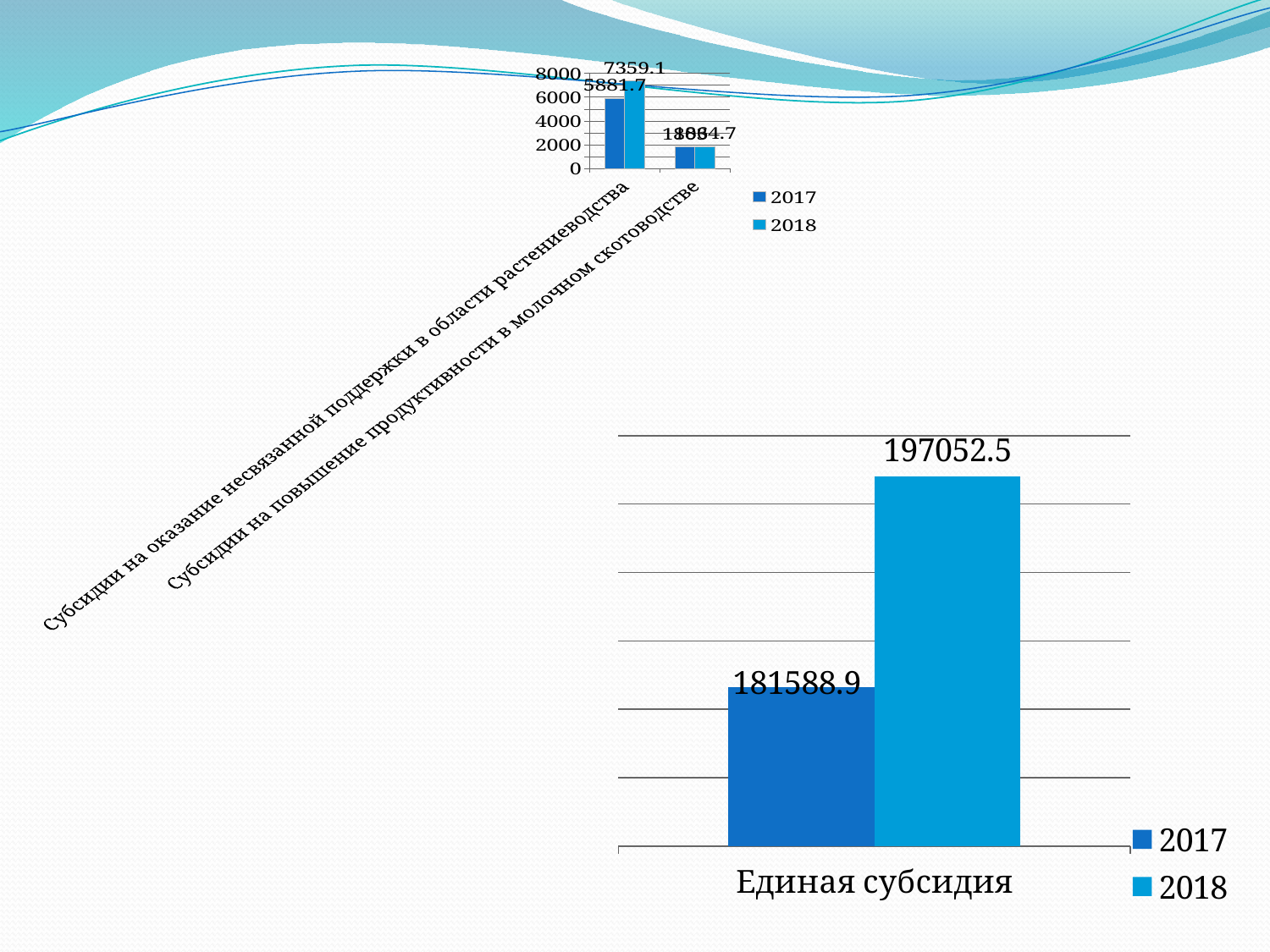
In the top-left chart, what is the 2018 value for Субсидии на оказание несвязанной поддержки в области растениеводства? 7359.1 In the top-left chart, is the 2017 value for Субсидии на повышение продуктивности в молочном скотоводстве greater or less than 4000? less In the top-left chart, what is the 2017 value for Субсидии на оказание несвязанной поддержки в области растениеводства? 5881.7 In the bottom-right chart, what is the value for 2018 for Единая субсидия? 197052.5 In the top-left chart, which year has the larger value for Субсидии на оказание несвязанной поддержки в области растениеводства, 2017 or 2018? 2018 How many series does the legend of the bottom-right chart list? 2 What kind of chart is the bottom-right chart? bar chart In the bottom-right chart, which year has the larger value for Единая субсидия, 2017 or 2018? 2018 In the bottom-right chart, what is the difference between the 2018 and 2017 values for Единая субсидия? 15463.6 What is the category label on the x axis of the bottom-right chart? Единая субсидия In the bottom-right chart, what is the value for 2017 for Единая субсидия? 181588.9 How many categories are shown on the x axis of the top-left chart? 2